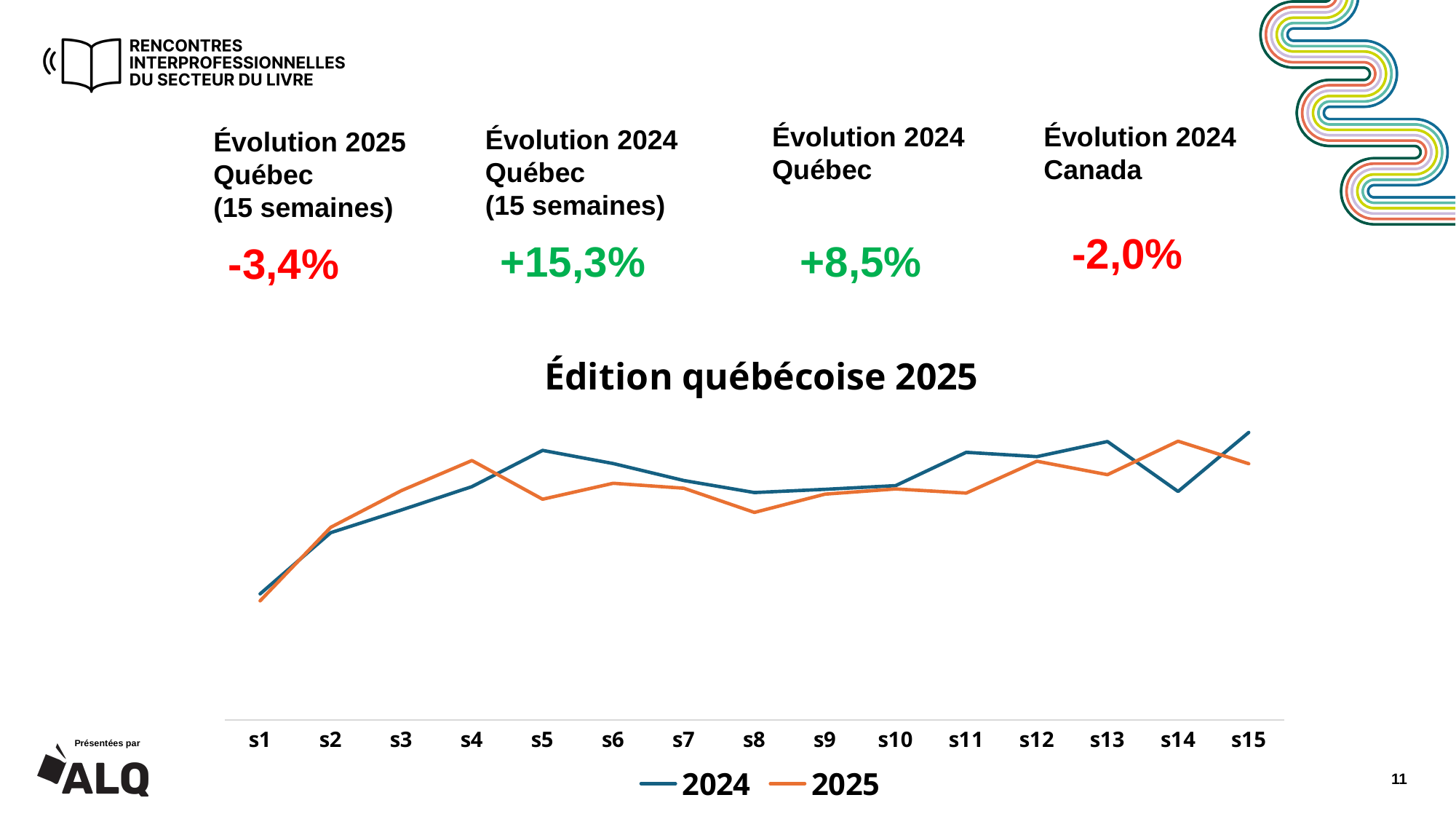
How many series does the chart legend list? 2 At s4, which series has the higher value, 2024 or 2025? 2025 At s8, which series has the higher value, 2024 or 2025? 2024 What kind of chart is shown on the slide? line chart At which week is the 2025 series at its highest? s14 What is the title of the chart? Édition québécoise 2025 At which week is the 2024 series at its lowest? s1 Which series are listed in the chart legend? 2024 and 2025 Do the values of the 2025 series rise or fall from s1 to s4? rise At s5, which series has the higher value, 2024 or 2025? 2024 How many weeks (points) are plotted along the x axis? 15